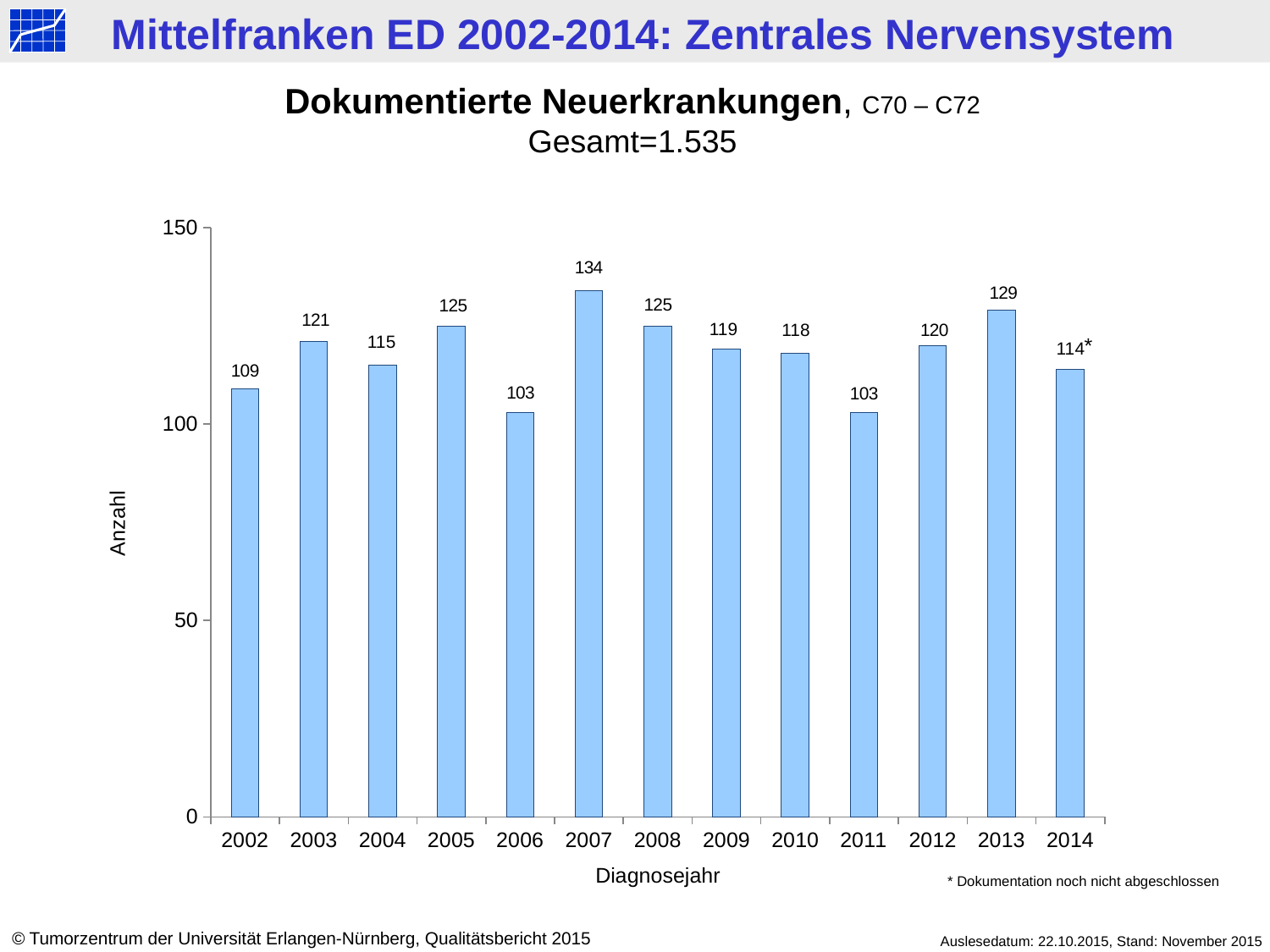
Is the value for 2011 greater or less than 100? greater What kind of chart is shown? bar chart What is the value for 2002? 109 What total is stated in the chart title? Gesamt=1.535 Which years share the lowest value? 2006 and 2011 What is the value for 2007? 134 How many years are shown on the x axis? 13 What is the difference between the values for 2007 and 2006? 31 Which year has the highest value? 2007 What is the label of the y axis? Anzahl What is the value for 2013? 129 Which is larger, the value for 2005 or the value for 2004? 2005